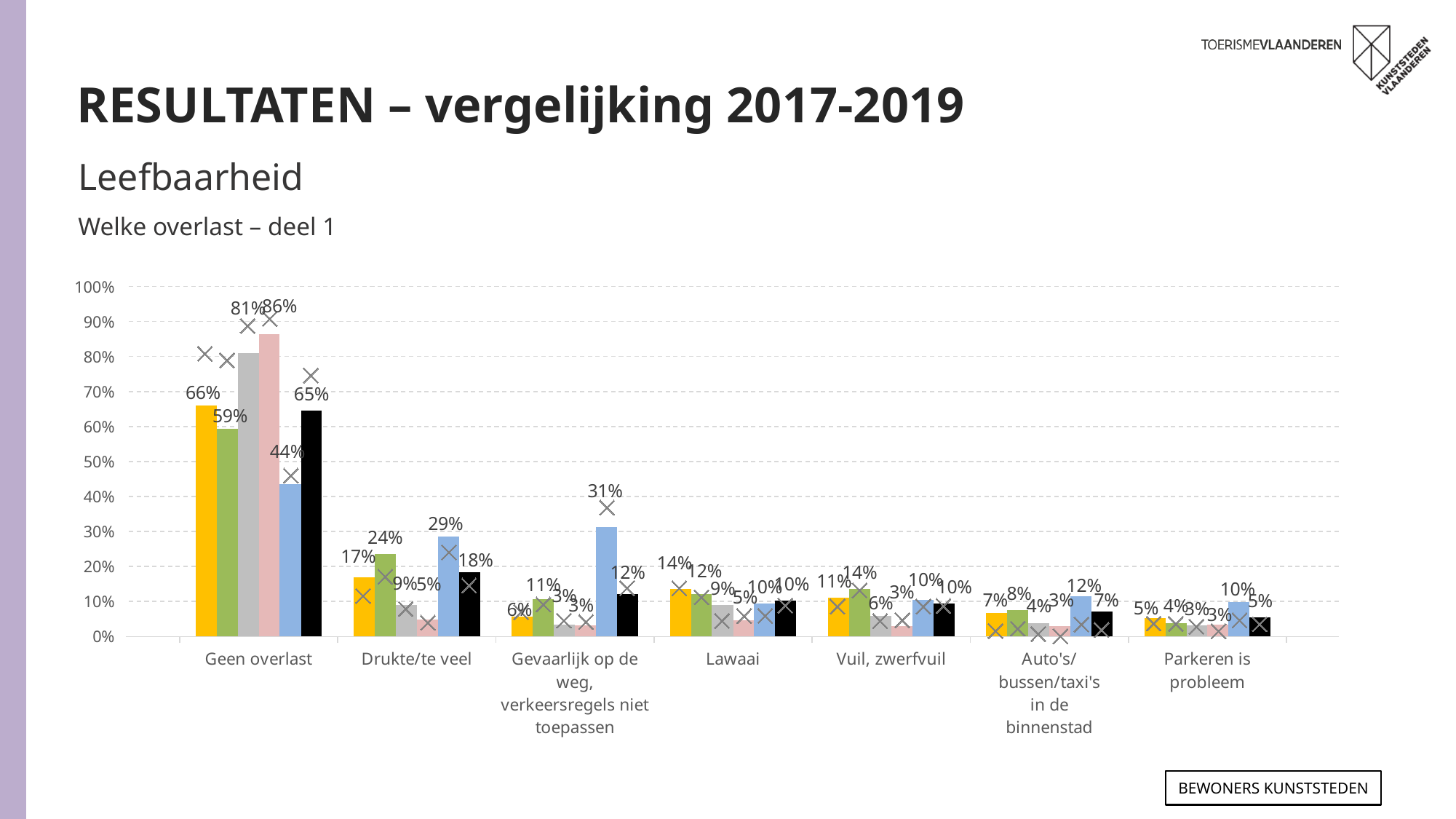
What is the value of the green bar for 'Drukte/te veel'? 24% For 'Drukte/te veel', which is larger: the blue bar or the black bar? the blue bar (29%) What is the difference between the pink bar (86%) and the blue bar (44%) for 'Geen overlast'? 42 percentage points Which bar has the lowest value in the 'Geen overlast' category? the blue bar (44%) Which bar has the highest value in the 'Geen overlast' category? the pink bar (86%) How many categories are shown along the x axis of the chart? 7 Is the value of the grey bar for 'Geen overlast' greater or less than 70%? greater What kind of chart is shown on the slide? bar chart What is the subtitle printed directly above the chart? Welke overlast – deel 1 What is the value of the blue bar for 'Gevaarlijk op de weg, verkeersregels niet toepassen'? 31% What is the value of the yellow bar for 'Geen overlast'? 66% How many bars are plotted for each category in the chart? 6